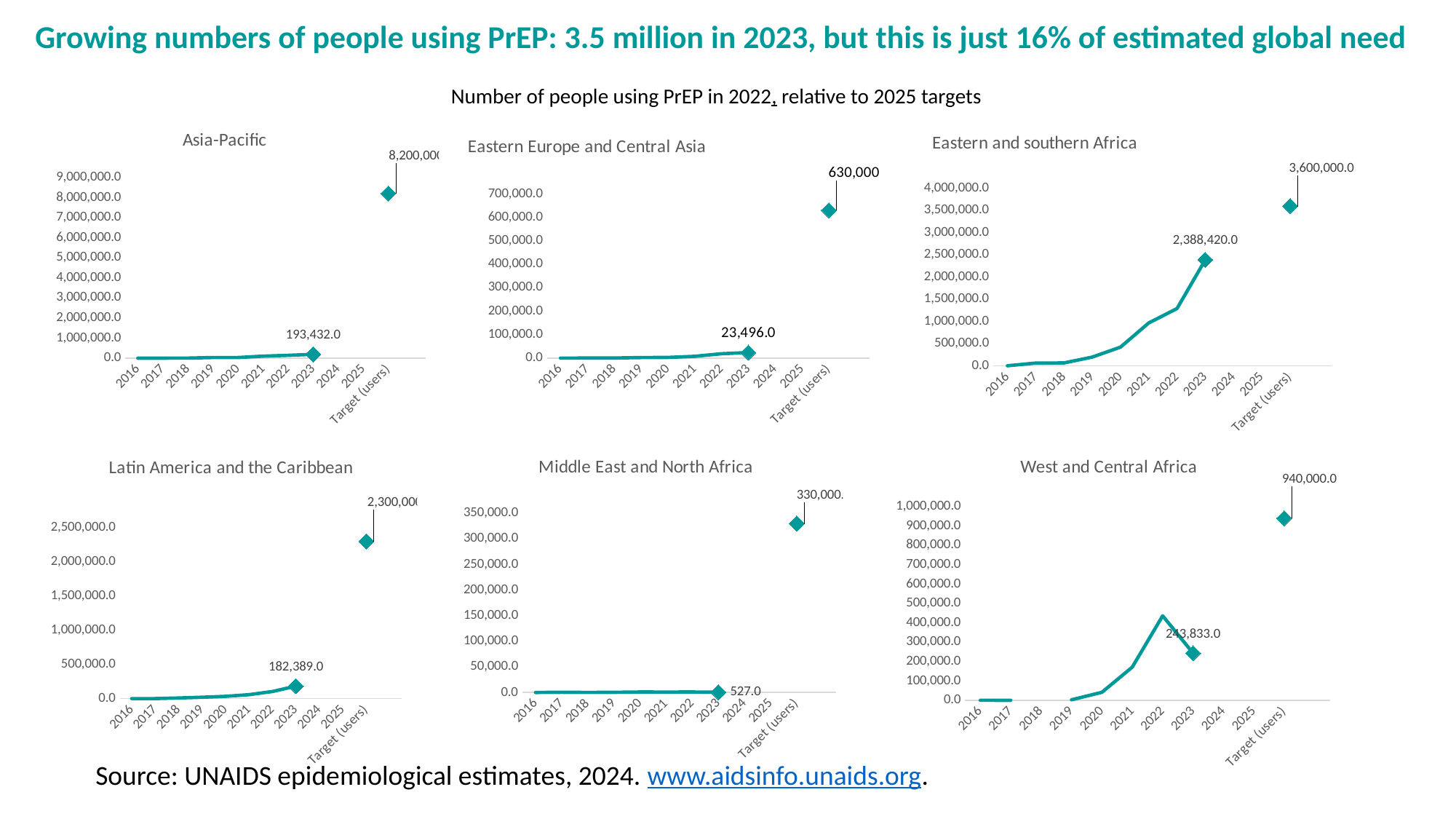
In the Eastern Europe and Central Asia chart, what is the value for 2023? 23,496.0 In the West and Central Africa chart, what is the target (users) value? 940,000.0 In the Eastern and southern Africa chart, what is the number of people using PrEP in 2023? 2,388,420.0 In the Latin America and the Caribbean chart, is the target (users) value greater or less than 2,000,000.0? greater Which is larger: the 2023 value in the Asia-Pacific chart or the 2023 value in the Latin America and the Caribbean chart? Asia-Pacific In the West and Central Africa chart, does the line rise or fall between 2022 and 2023? fall How many regional charts are shown on the slide? 6 In the Eastern and southern Africa chart, what is the difference between the target (users) and the 2023 value? 1,211,580.0 In the Eastern and southern Africa chart, what is the 2025 target (users)? 3,600,000.0 In the Asia-Pacific chart, what is the value for 2023? 193,432.0 In the Middle East and North Africa chart, what is the value for 2023? 527.0 In the Eastern Europe and Central Asia chart, what is the target (users) value? 630,000